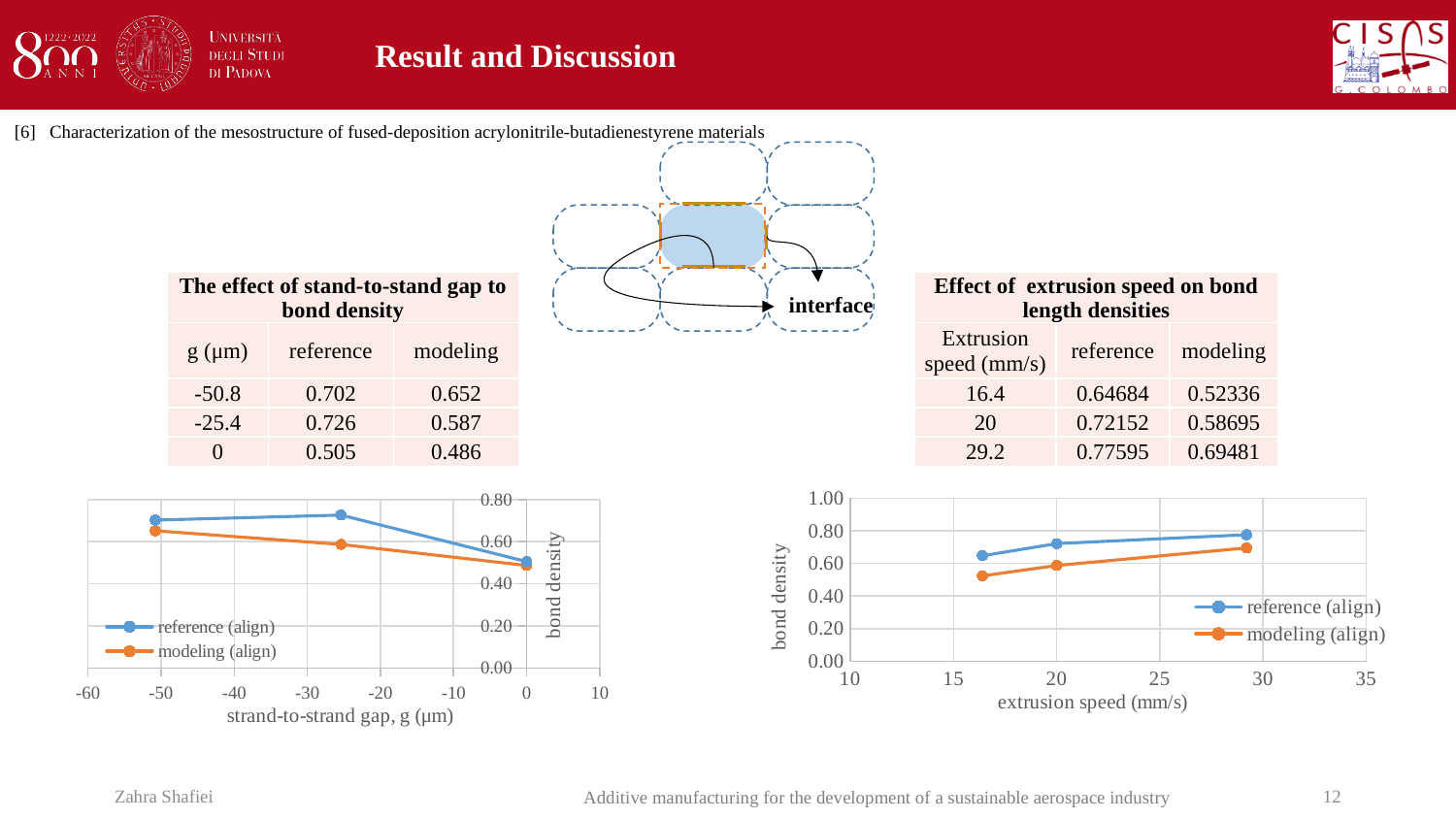
In the right chart (bond density vs extrusion speed), how many series does the legend list? 2 In the right chart (bond density vs extrusion speed), which series is higher at an extrusion speed of 20 mm/s? reference (align) In the left chart (bond density vs strand-to-strand gap), which series has the higher value at a gap of -25.4 µm? reference (align) In the right chart (bond density vs extrusion speed), do the bond density values rise or fall as extrusion speed increases? rise In the left chart (bond density vs strand-to-strand gap), what are the two legend entries? reference (align) and modeling (align) What kind of chart is the left chart, plotting bond density against strand-to-strand gap? line chart What is the x-axis label of the right chart? extrusion speed (mm/s) In the left chart (bond density vs strand-to-strand gap), at which gap value is the modeling (align) series lowest? 0 In the right chart (bond density vs extrusion speed), how many data points does each series have? 3 In the right chart (bond density vs extrusion speed), is the modeling (align) value at an extrusion speed of 16.4 mm/s greater or less than 0.60? less In the left chart (bond density vs strand-to-strand gap), is the modeling (align) value at a gap of -50.8 greater or less than 0.60? greater In the left chart (bond density vs strand-to-strand gap), is the reference (align) value at a gap of -25.4 greater or less than 0.60? greater